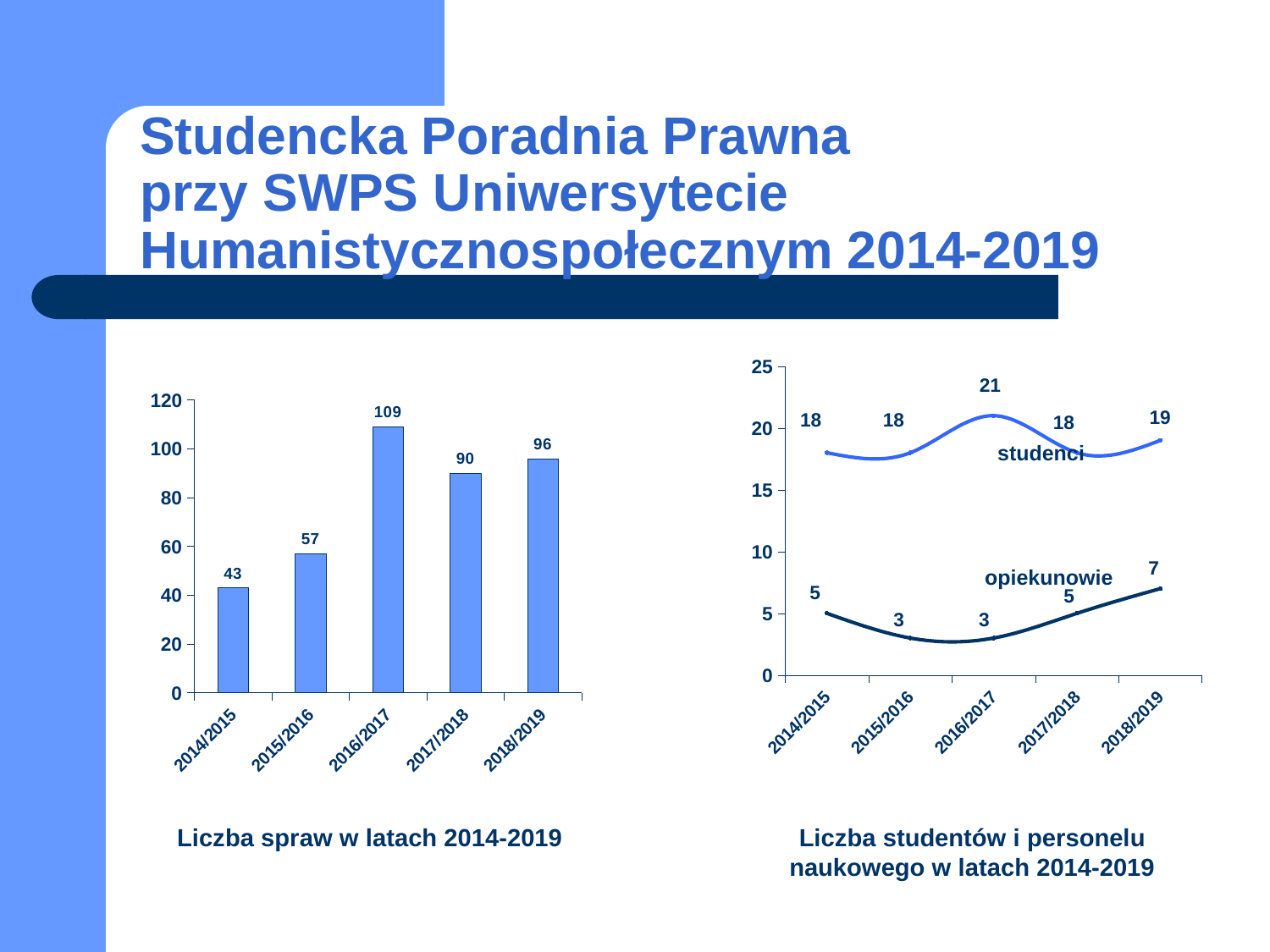
In the right chart (Liczba studentów i personelu naukowego w latach 2014-2019), what is the value for studenci in 2016/2017? 21 In the right chart (Liczba studentów i personelu naukowego w latach 2014-2019), what is the difference between studenci and opiekunowie in 2018/2019? 12 In the right chart (Liczba studentów i personelu naukowego w latach 2014-2019), how many series are plotted? 2 In the left chart (Liczba spraw w latach 2014-2019), which year has the lowest value? 2014/2015 In the left chart (Liczba spraw w latach 2014-2019), how many years are shown on the x axis? 5 In the left chart (Liczba spraw w latach 2014-2019), what is the value for 2016/2017? 109 In the left chart (Liczba spraw w latach 2014-2019), which year has the highest value? 2016/2017 In the right chart (Liczba studentów i personelu naukowego w latach 2014-2019), what is the value for opiekunowie in 2018/2019? 7 In the right chart (Liczba studentów i personelu naukowego w latach 2014-2019), which is larger in 2014/2015: studenci or opiekunowie? studenci In the left chart (Liczba spraw w latach 2014-2019), what is the difference between the values for 2016/2017 and 2017/2018? 19 What kind of chart is the right chart (Liczba studentów i personelu naukowego w latach 2014-2019)? line chart What kind of chart is the left chart (Liczba spraw w latach 2014-2019)? bar chart